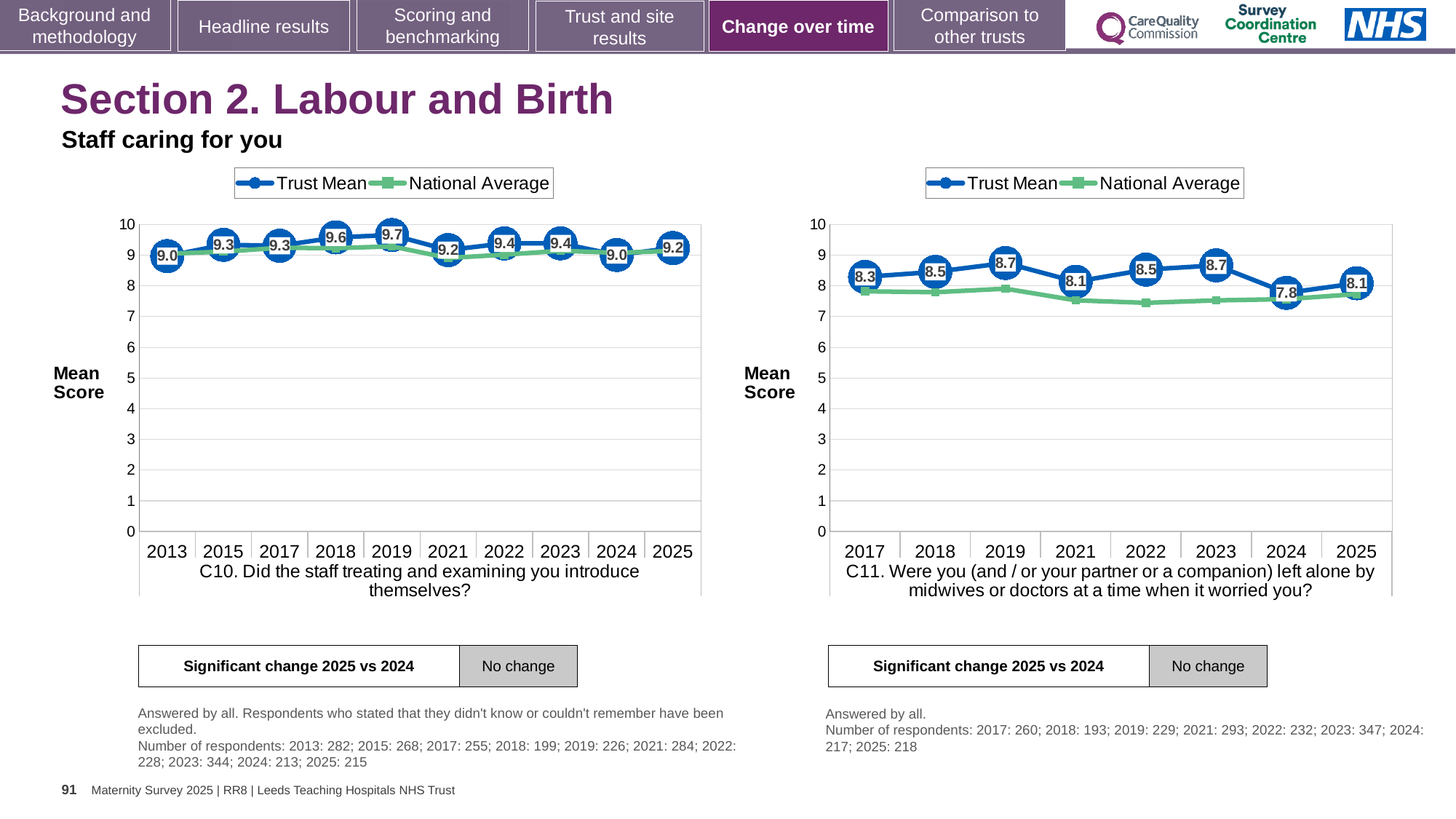
In the C11 chart on the right, what is the difference between the Trust Mean scores for 2025 and 2024? 0.3 In the C11 chart on the right, which year has the lowest Trust Mean score? 2024 In the C11 chart on the right, what is the Trust Mean score for 2021? 8.1 In the C11 chart on the right, is the National Average value for 2022 greater or less than 8? less In the C10 chart on the left, what is the Trust Mean score for 2019? 9.7 How many series does the legend of the C11 chart on the right list? 2 How many years are shown on the x axis of the C10 chart on the left? 10 In the C11 chart on the right, what is the Trust Mean score for 2024? 7.8 In the C10 chart on the left, which year has the highest Trust Mean score? 2019 In the C10 chart on the left, what is the difference between the Trust Mean scores for 2019 and 2024? 0.7 In the C10 chart on the left, what is the Trust Mean score for 2025? 9.2 In the C11 chart on the right, is the Trust Mean score higher in 2019 or in 2021? 2019